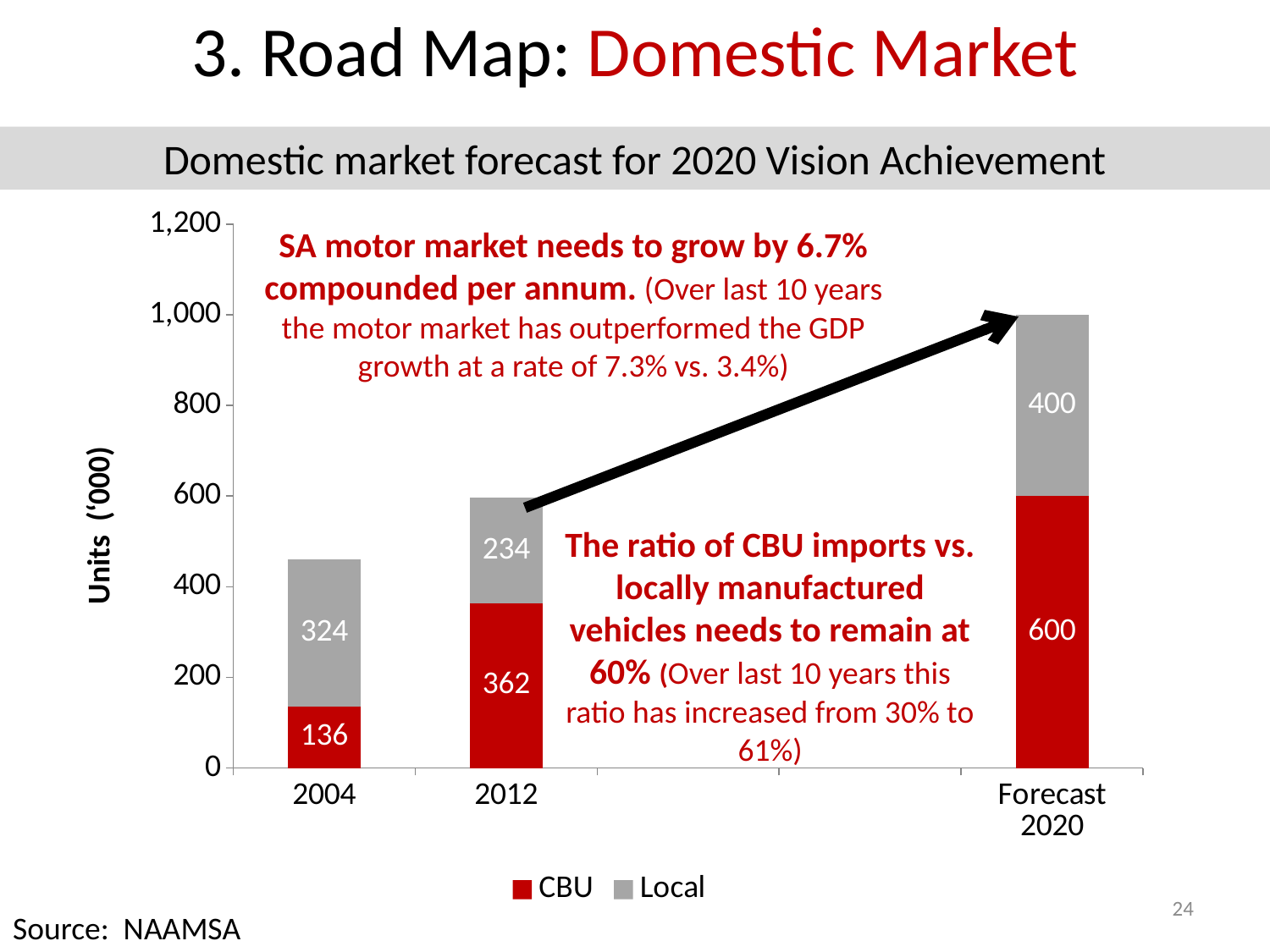
What is the Local value for Forecast 2020? 400 Which is larger in 2012, the CBU value or the Local value? CBU What is the CBU value for Forecast 2020? 600 What kind of chart is shown on the slide? Stacked bar chart What is the total of the stacked bar for 2004? 460 What is the total of the stacked bar for Forecast 2020? 1,000 How many series does the legend list? 2 What is the Local value for 2012? 234 Which category has the highest CBU value? Forecast 2020 What is the difference between the CBU values for 2012 and 2004? 226 What is the CBU value for 2004? 136 Which category has the lowest Local value? 2012